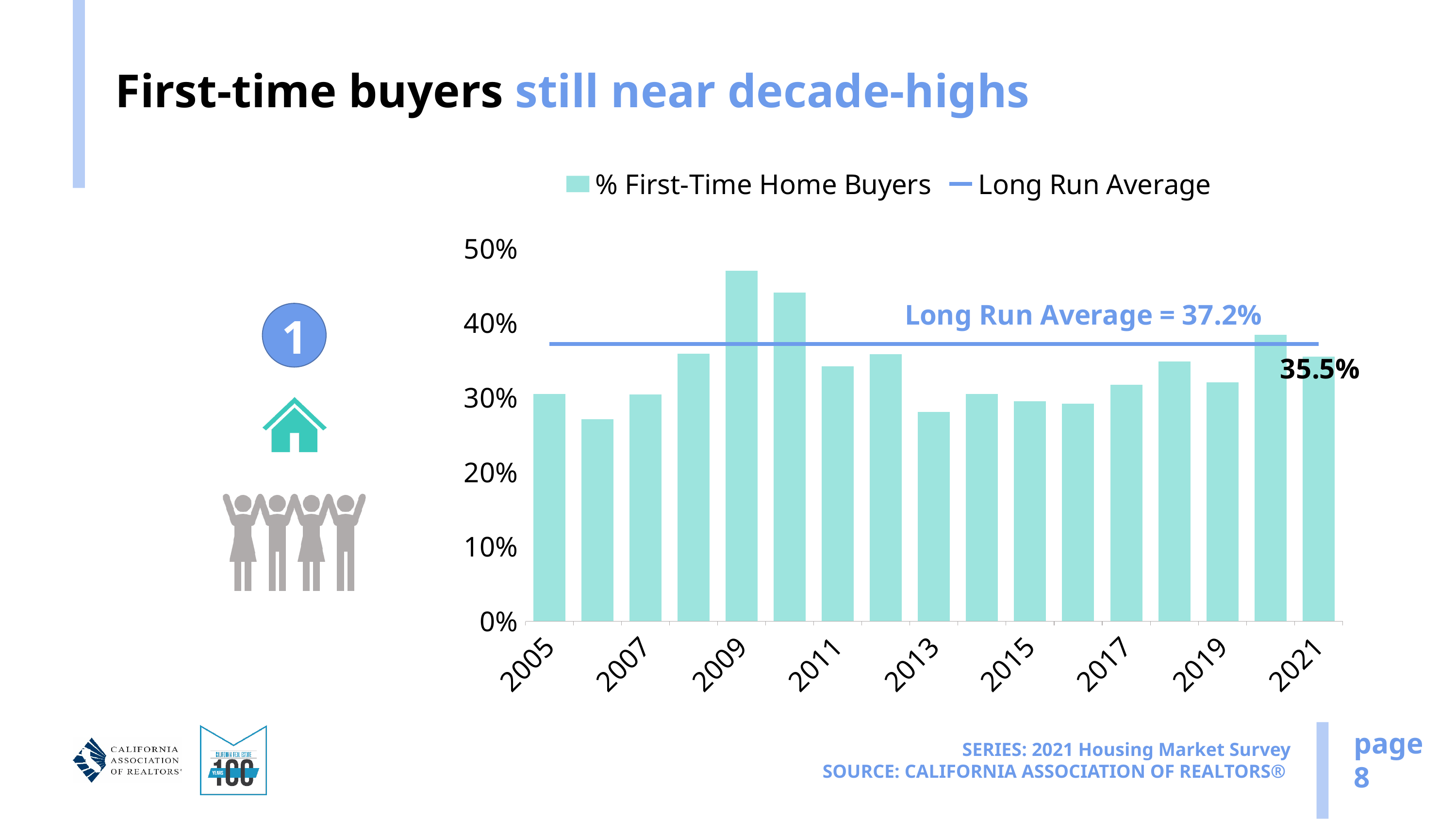
What kind of chart is shown on the slide? bar chart What is the value for % First-Time Home Buyers in 2021? 35.5% What is the Long Run Average shown on the chart? 37.2% By how many percentage points is the 2021 value below the Long Run Average? 1.7% How many bars are plotted in the chart? 17 Which is larger, the 2021 value or the Long Run Average? Long Run Average Which year has the highest share of first-time home buyers? 2009 Is the value for 2013 greater or less than 30%? less Is the value for 2009 greater or less than 40%? greater Which is larger, the value for 2009 or the value for 2010? 2009 What are the two entries in the chart legend? % First-Time Home Buyers; Long Run Average How many series does the legend list? 2